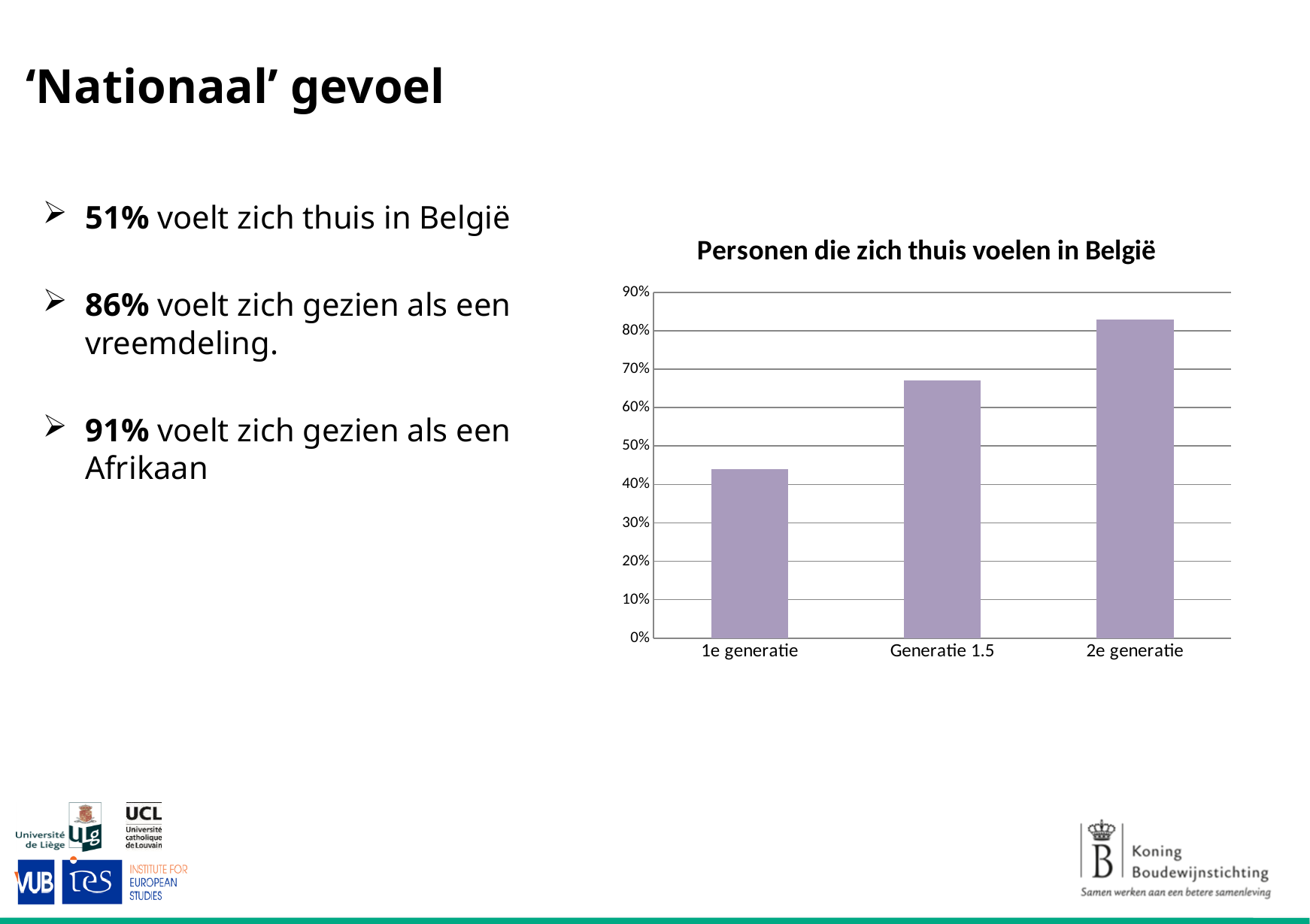
How many categories are shown on the x axis of the chart? 3 Which category has the highest value in the chart? 2e generatie Is the value for 1e generatie greater or less than 50%? less Is the value for 1e generatie greater or less than 40%? greater Which category has the lowest value in the chart? 1e generatie Which is larger, the value for Generatie 1.5 or the value for 2e generatie? 2e generatie Is the value for Generatie 1.5 greater or less than 60%? greater Do the values rise or fall from 1e generatie to 2e generatie along the x axis? rise What is the title of the chart? Personen die zich thuis voelen in België What is the highest value shown on the y axis of the chart? 90% What kind of chart is shown on the slide? bar chart